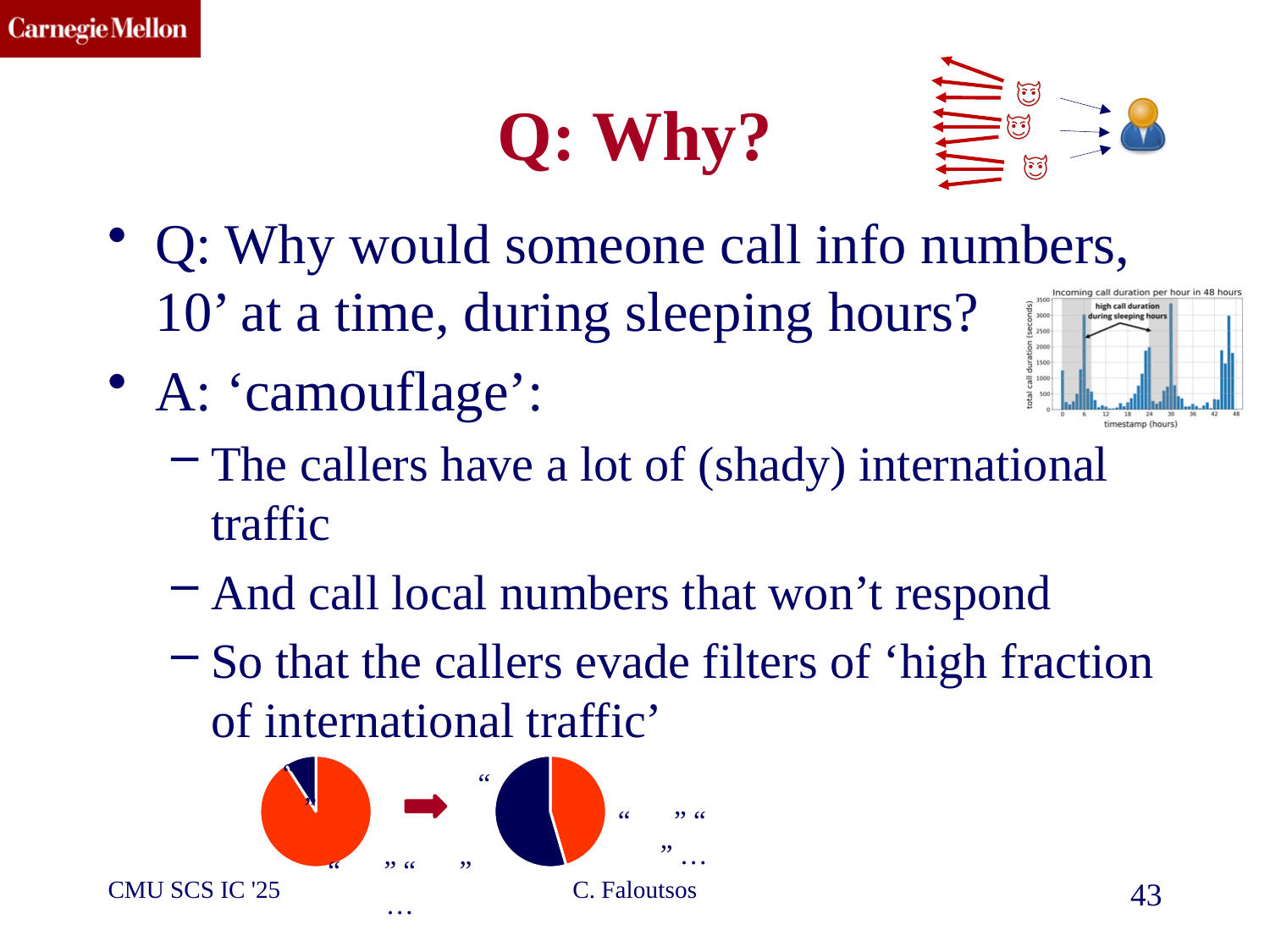
In the left pie chart at the bottom of the slide, which colour slice is larger, orange or dark blue? orange In the 'Incoming call duration per hour in 48 hours' chart, is the total call duration around hour 12 greater or less than 1000 seconds? less What kind of charts are the two charts at the bottom of the slide? pie charts In the 'Incoming call duration per hour in 48 hours' chart, what is the highest tick value shown on the x axis? 48 What kind of chart is the 'Incoming call duration per hour in 48 hours' chart? bar chart In the 'Incoming call duration per hour in 48 hours' chart, what is the label of the x axis? timestamp (hours) What is the title of the bar chart in the upper right of the slide? Incoming call duration per hour in 48 hours In the 'Incoming call duration per hour in 48 hours' chart, is the tallest bar greater or less than 2500 seconds? greater In the 'Incoming call duration per hour in 48 hours' chart, is the total call duration around hour 36 greater or less than 1500 seconds? less How many slices does the left pie chart at the bottom of the slide have? 2 In the 'Incoming call duration per hour in 48 hours' chart, what is the highest tick value shown on the y axis? 3500